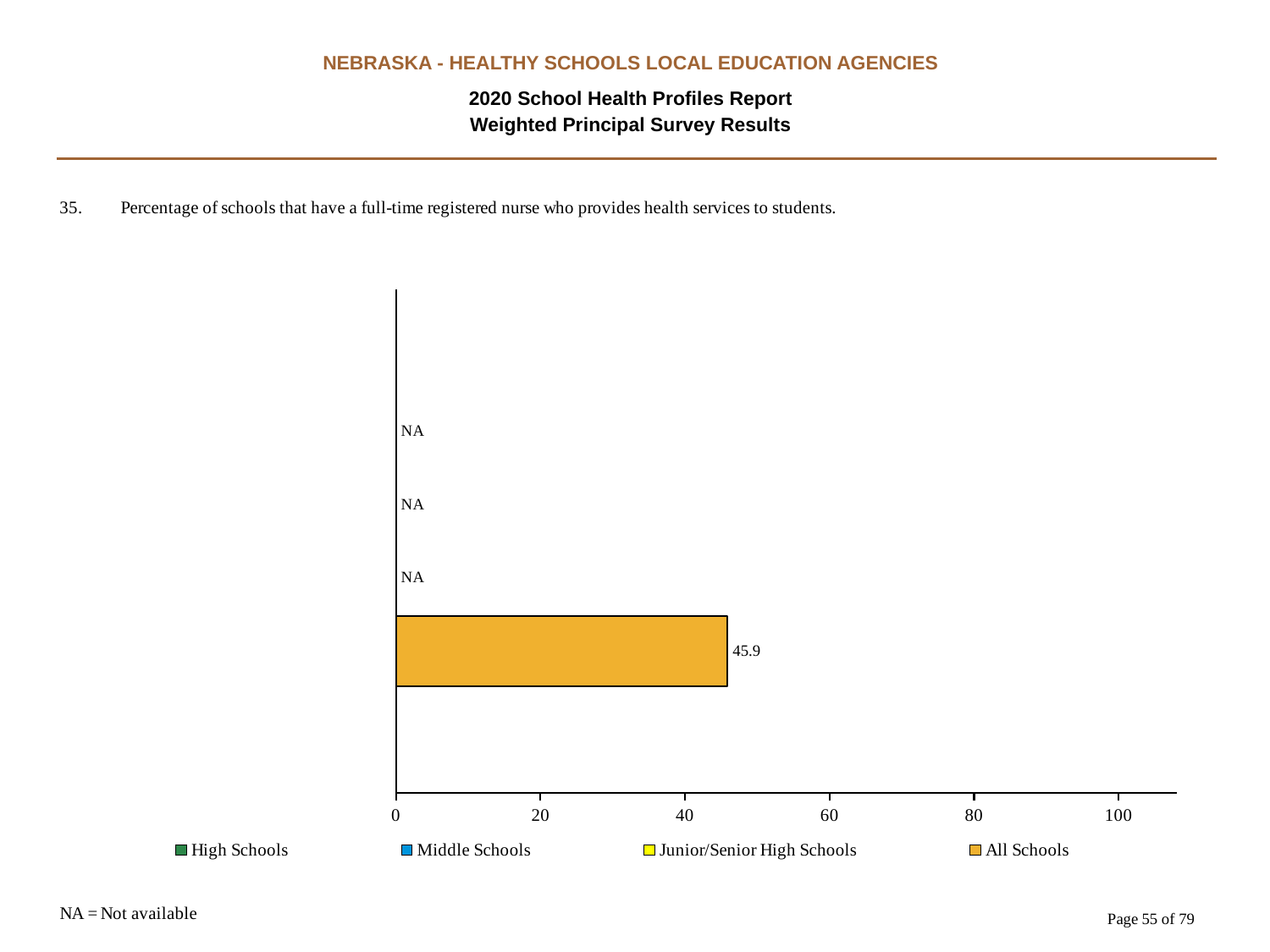
What kind of chart is shown on the slide? bar chart What is shown for High Schools? NA Is the value for All Schools greater or less than 40? greater What is shown for Junior/Senior High Schools? NA Which series has a plotted bar with a numeric value? All Schools How many series are marked NA on the chart? 3 What is shown for Middle Schools? NA How many series does the legend list? 4 Is the value for All Schools greater or less than 60? less What is the value for All Schools? 45.9 What is the highest value shown on the x axis? 100